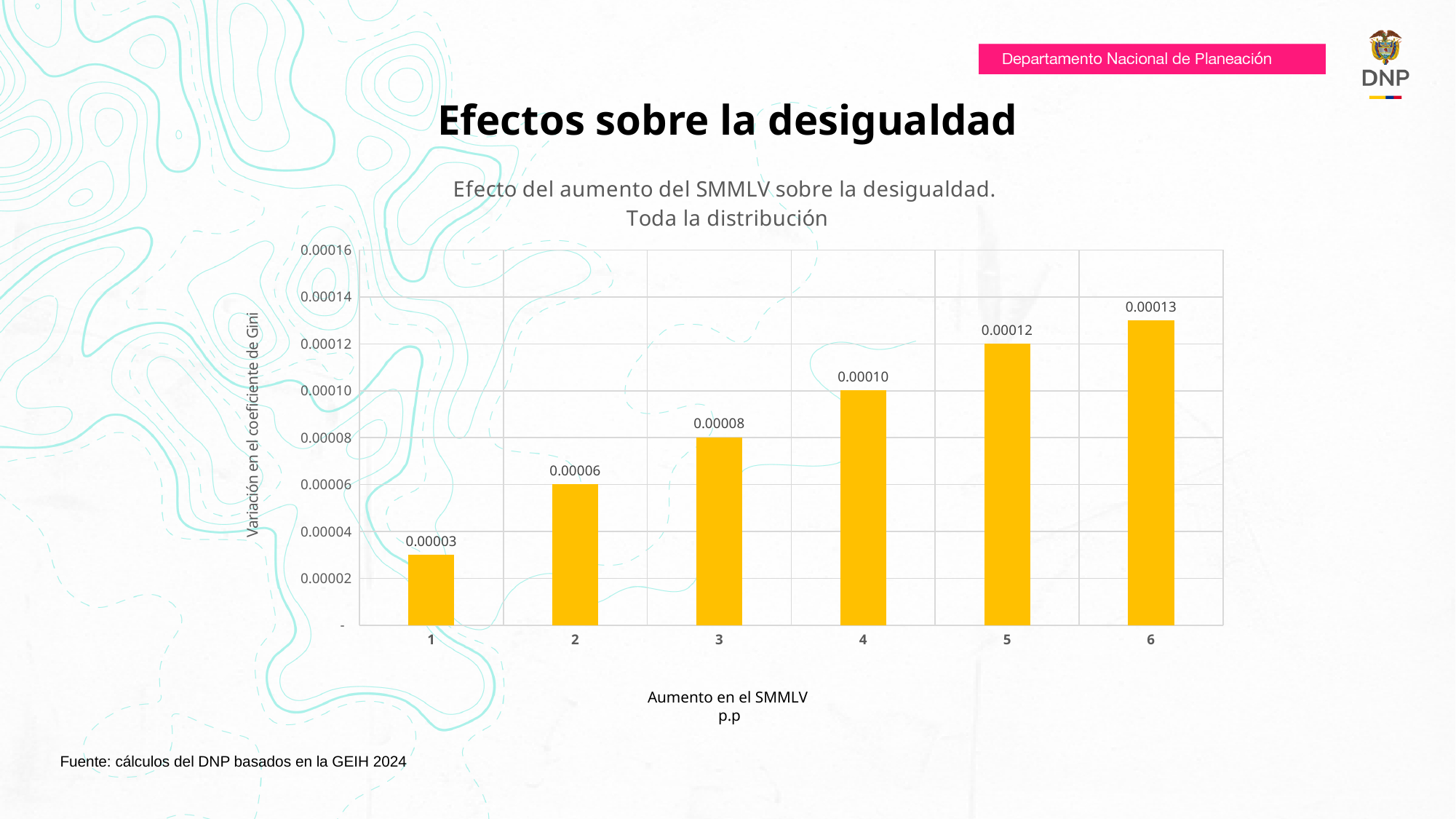
Which SMMLV increase has the lowest variation in the Gini coefficient? 1 Which SMMLV increase has the highest variation in the Gini coefficient? 6 What is the value for an SMMLV increase of 1 p.p.? 0.00003 What is the difference between the values for an increase of 5 p.p. and an increase of 2 p.p.? 0.00006 What is the value for an SMMLV increase of 3 p.p.? 0.00008 Do the values rise or fall as the SMMLV increase grows along the x axis? Rise What is the label of the y axis? Variación en el coeficiente de Gini What is the value for an SMMLV increase of 6 p.p.? 0.00013 How many bars are shown in the chart? 6 Is the value for an SMMLV increase of 5 p.p. greater or less than 0.00010? greater Which is larger, the value for an increase of 4 p.p. or the value for an increase of 2 p.p.? 4 p.p. What kind of chart is shown on the slide? Bar chart